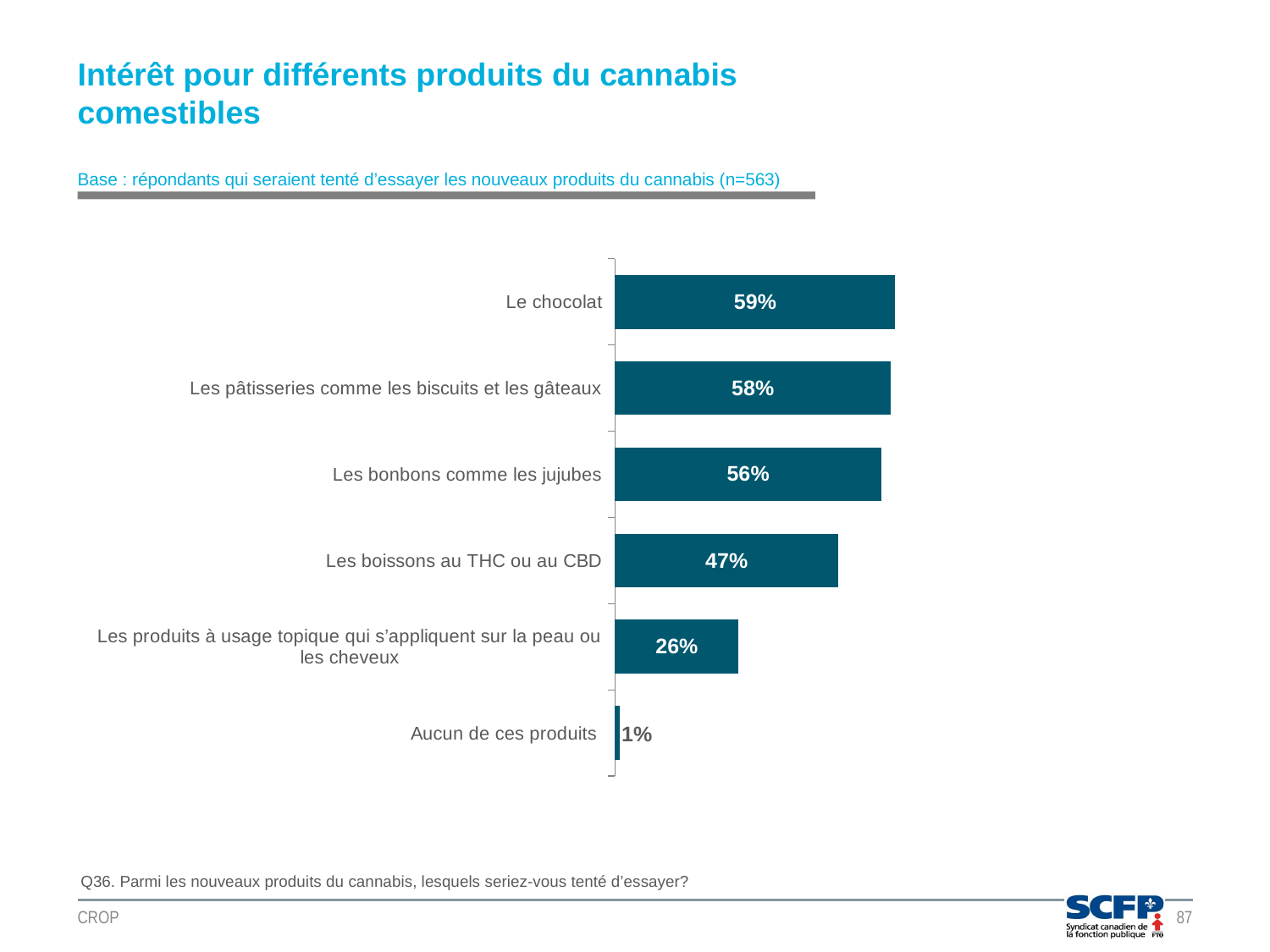
How many categories are shown in the chart? 6 Which category has the lowest value? Aucun de ces produits Which is larger: the value for 'Les bonbons comme les jujubes' or for 'Les boissons au THC ou au CBD'? Les bonbons comme les jujubes What percentage is shown for 'Aucun de ces produits'? 1% What is the value for 'Les produits à usage topique qui s'appliquent sur la peau ou les cheveux'? 26% What is the difference between 'Les bonbons comme les jujubes' and 'Les produits à usage topique qui s'appliquent sur la peau ou les cheveux'? 30% What is the base size (n) stated for the chart? n=563 What is the difference between the values for 'Le chocolat' and 'Les boissons au THC ou au CBD'? 12% What is the value shown for 'Les boissons au THC ou au CBD'? 47% What kind of chart is shown on the slide? Bar chart What percentage of respondents are interested in 'Le chocolat'? 59% Which category has the highest value? Le chocolat